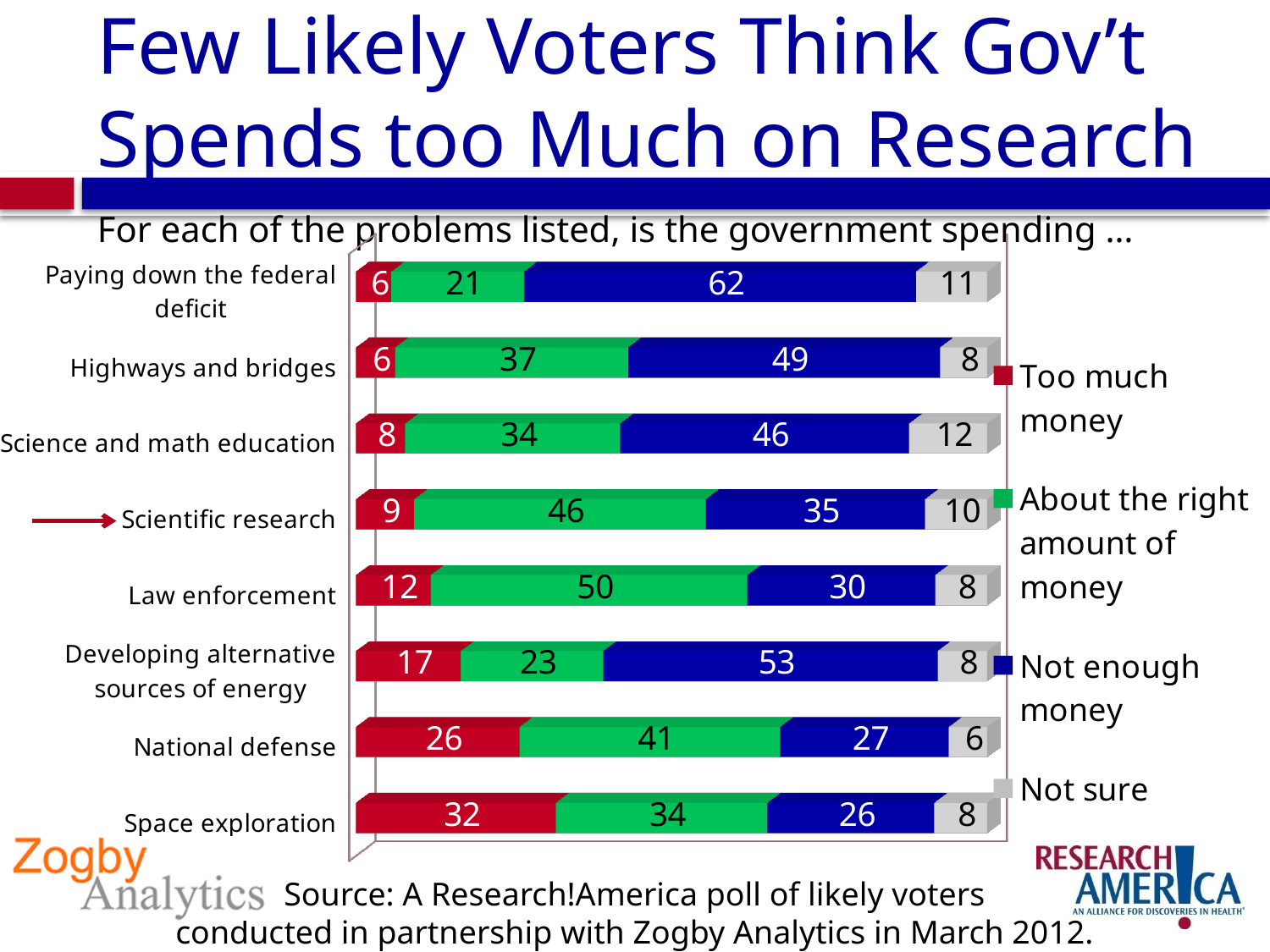
Which is larger: the 'About the right amount of money' value for national defense or for highways and bridges? National defense What is the difference between the 'Not enough money' values for paying down the federal deficit and scientific research? 27 How many series does the legend list? 4 What percentage of likely voters say the government spends too much money on space exploration? 32 What is the 'Not sure' value for science and math education? 12 What is the 'About the right amount of money' value for law enforcement? 50 How many categories are shown in the chart? 8 Which category has the lowest 'Not enough money' value? Space exploration What kind of chart is shown on the slide? Stacked bar chart Which category has the highest 'Too much money' value? Space exploration What is the total of the stacked bar for scientific research? 100 What is the 'Not enough money' value for paying down the federal deficit? 62